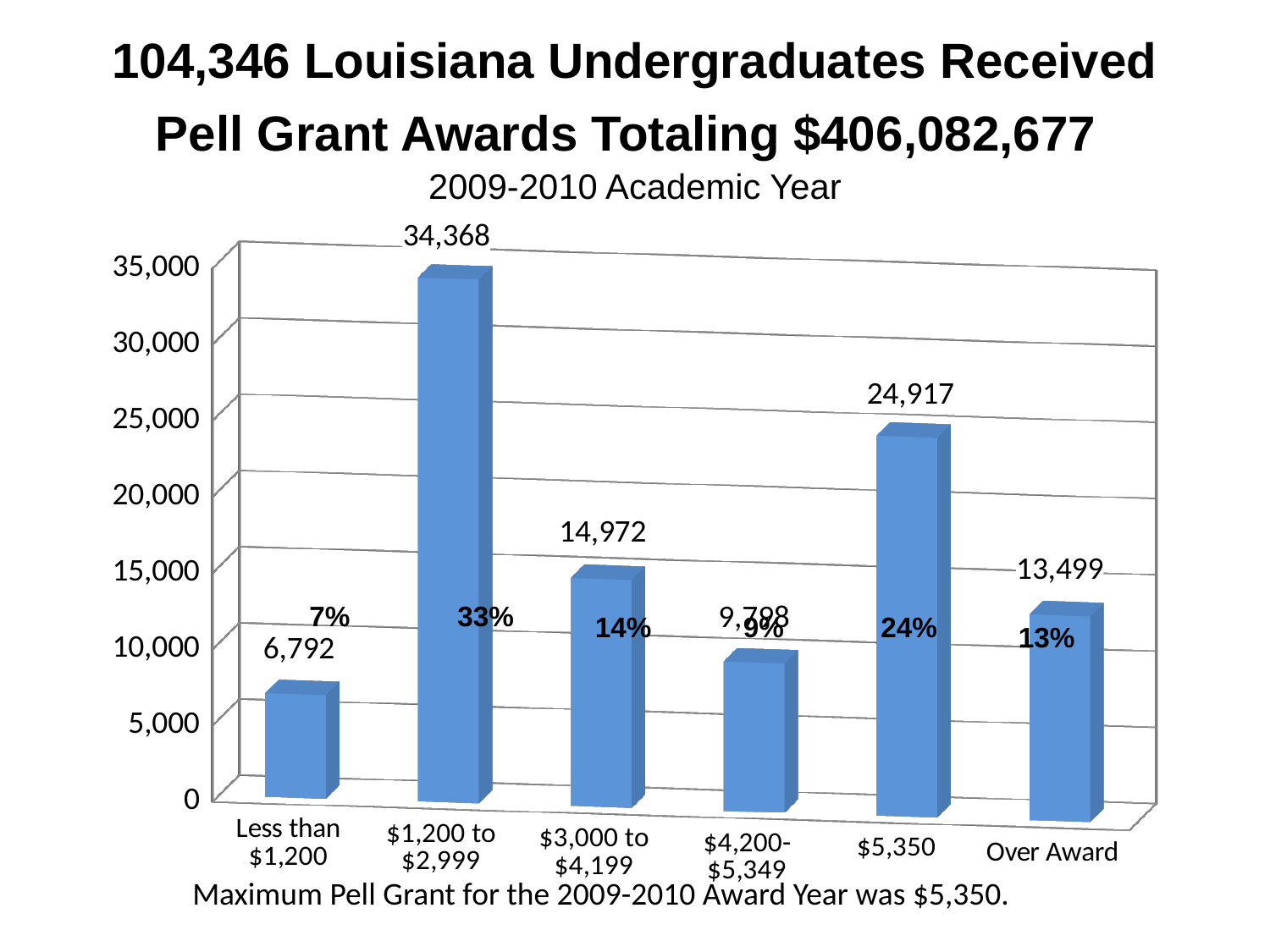
What is the value shown for the Less than $1,200 category? 6,792 What is the difference between the $3,000 to $4,199 value and the Over Award value? 1,473 Which award range has the lowest number of recipients? Less than $1,200 What is the value shown for the $5,350 category? 24,917 What is the difference between the $1,200 to $2,999 value and the $5,350 value? 9,451 Which is larger, the value for $3,000 to $4,199 or the value for Over Award? $3,000 to $4,199 How many Louisiana undergraduates received Pell Grant awards of $1,200 to $2,999? 34,368 Is the value for $4,200-$5,349 greater or less than 10,000? less What kind of chart is shown on the slide? bar chart Which award range has the highest number of recipients? $1,200 to $2,999 How many award categories are shown on the x axis? 6 What is the value shown for the Over Award category? 13,499